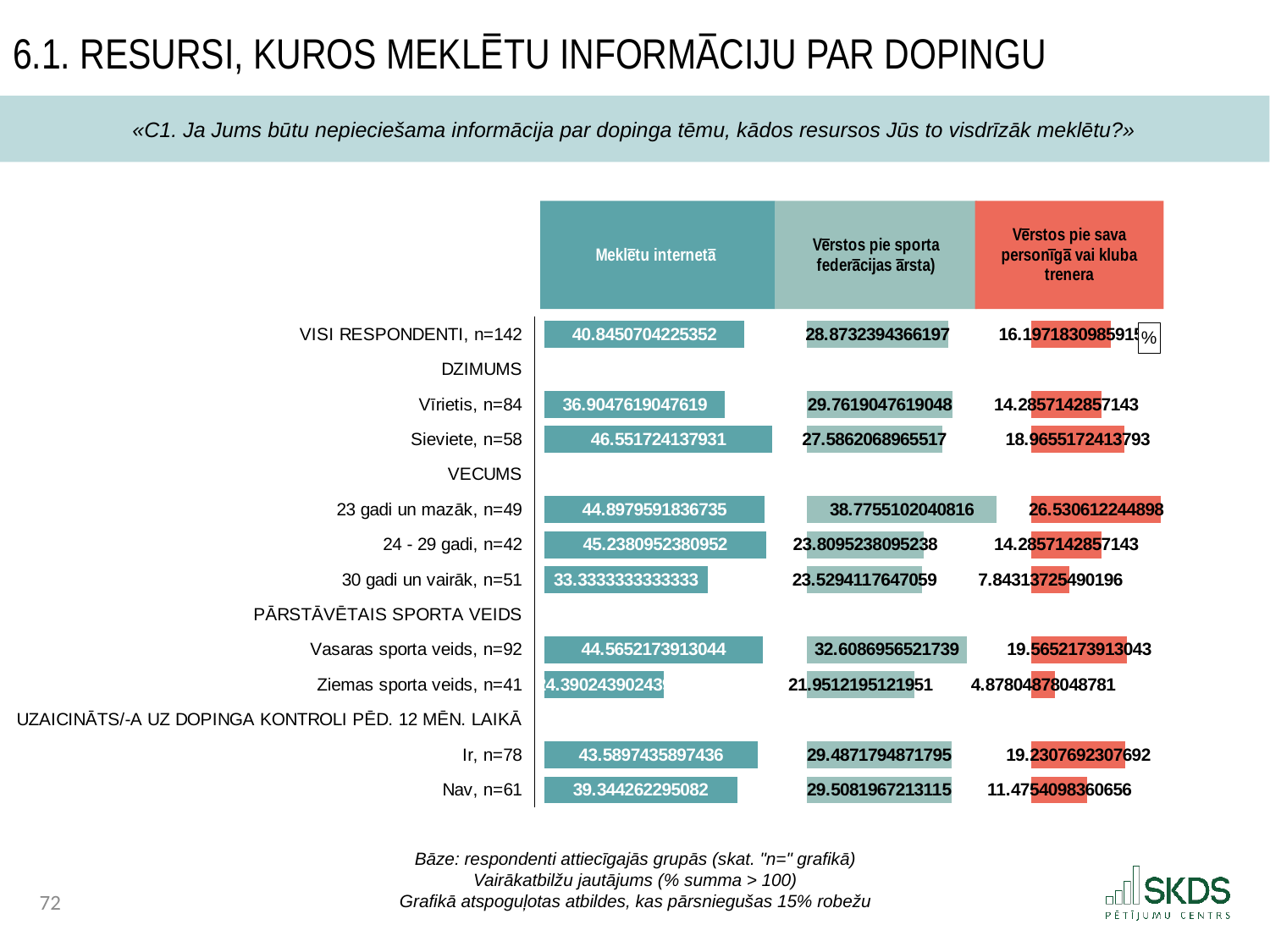
How many series does the chart show? 3 In the "Meklētu internetā" series, which is larger: "Vīrietis, n=84" or "Sieviete, n=58"? Sieviete, n=58 What is the value for "Ir, n=78" in the "Meklētu internetā" series? 43.5897435897436 Which group has the lowest value in the "Vērstos pie sporta federācijas ārsta)" series? Ziemas sporta veids, n=41 What is the value for "23 gadi un mazāk, n=49" in the "Vērstos pie sporta federācijas ārsta)" series? 38.7755102040816 Which group has the highest value in the "Vērstos pie sava personīgā vai kluba trenera" series? 23 gadi un mazāk, n=49 What is the value for "30 gadi un vairāk, n=51" in the "Vērstos pie sava personīgā vai kluba trenera" series? 7.84313725490196 What kind of chart is shown on the slide? Bar chart What is the value for "Sieviete, n=58" in the "Meklētu internetā" series? 46.551724137931 Which group has the lowest value in the "Vērstos pie sava personīgā vai kluba trenera" series? Ziemas sporta veids, n=41 Which group has the highest value in the "Meklētu internetā" series? Sieviete, n=58 What is the label of the first (left-most) series in the chart header? Meklētu internetā